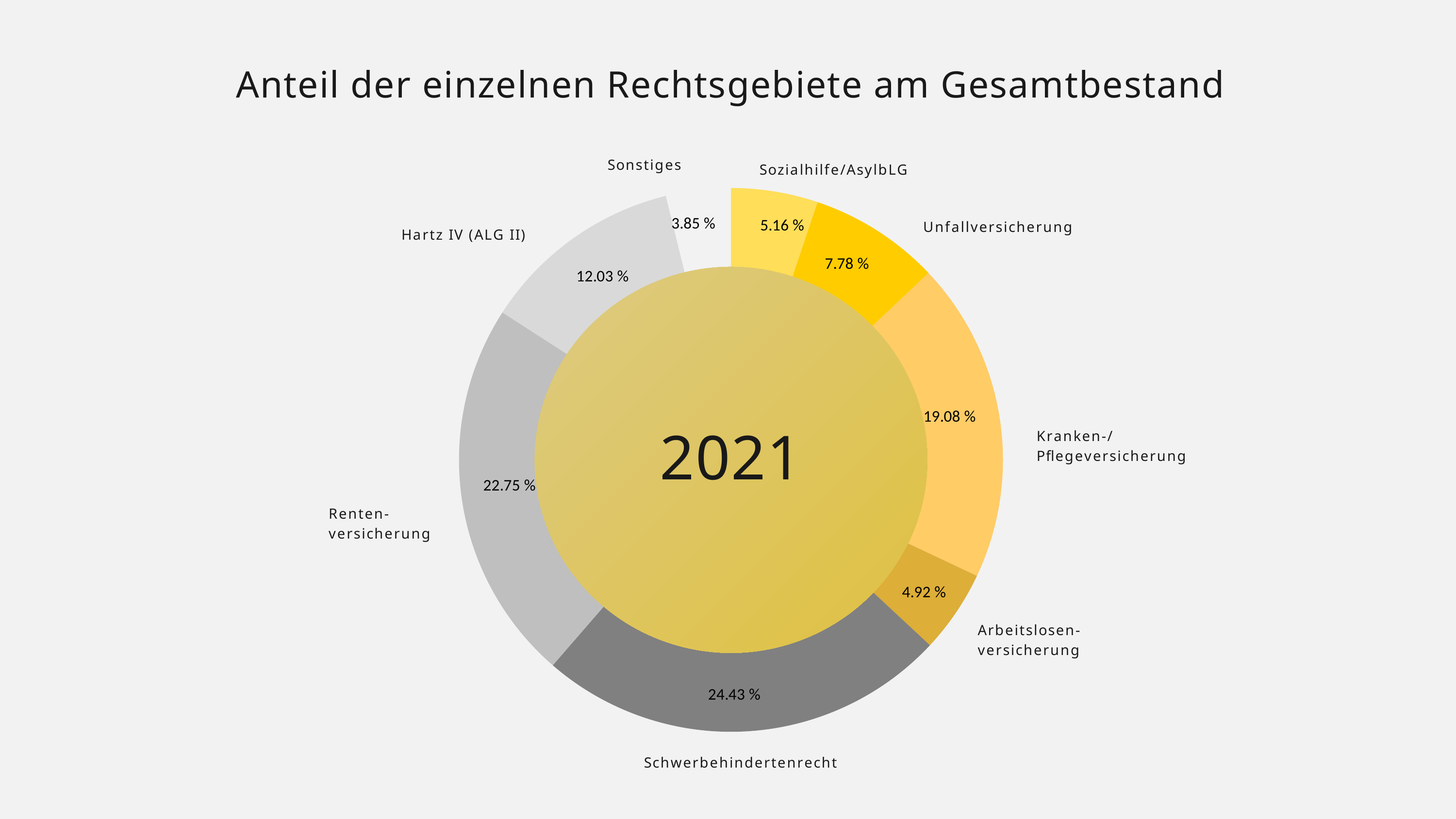
What share does Rentenversicherung have in the chart? 22.75 % Which category has the smallest share in the chart? Sonstiges What share does Kranken-/Pflegeversicherung have in the chart? 19.08 % Which has a larger share, Sozialhilfe/AsylbLG or Arbeitslosenversicherung? Sozialhilfe/AsylbLG What kind of chart is shown on the slide? Doughnut chart What share does Unfallversicherung have in the chart? 7.78 % What year is shown in the centre of the chart? 2021 What share does Hartz IV (ALG II) have in the chart? 12.03 % How many categories are shown in the chart? 8 What is the difference between the shares of Schwerbehindertenrecht and Rentenversicherung? 1.68 % Which category has the largest share in the chart? Schwerbehindertenrecht What share does Schwerbehindertenrecht have in the chart? 24.43 %